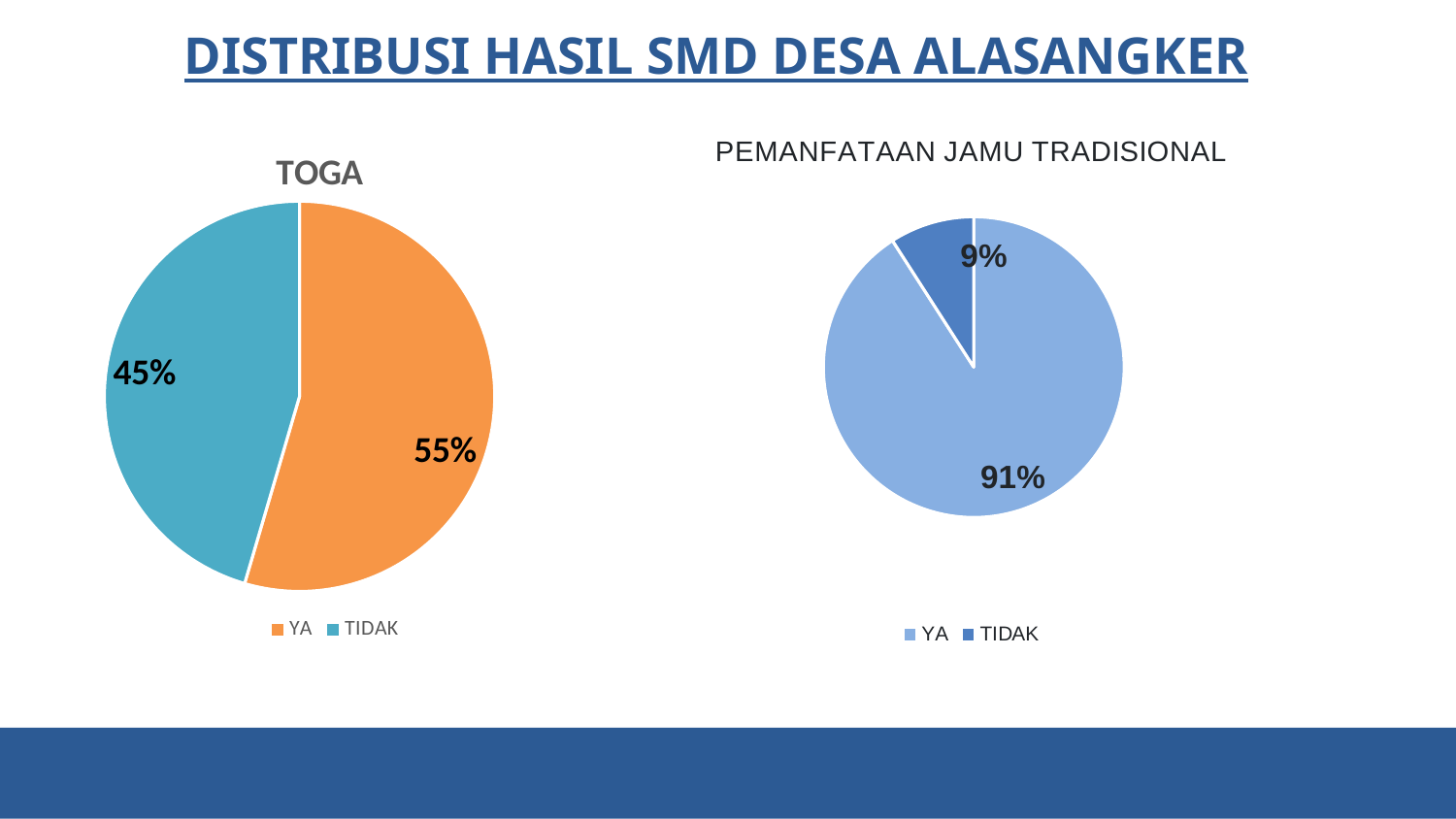
In the TOGA chart, what is the difference between the YA and TIDAK shares? 10% In the TOGA chart, which category has the largest slice? YA In the TOGA chart, which is larger, YA or TIDAK? YA In the PEMANFATAAN JAMU TRADISIONAL chart, which category has the smallest slice? TIDAK In the PEMANFATAAN JAMU TRADISIONAL chart, what share of the pie is TIDAK? 9% In the PEMANFATAAN JAMU TRADISIONAL chart, what is the difference between the YA and TIDAK shares? 82% In the TOGA chart, what colour is the YA slice? Orange What kind of chart is the PEMANFATAAN JAMU TRADISIONAL chart? Pie chart How many categories does the TOGA chart show? 2 In the TOGA chart, what share of the pie is TIDAK? 45% In the TOGA chart, what share of the pie is YA? 55%